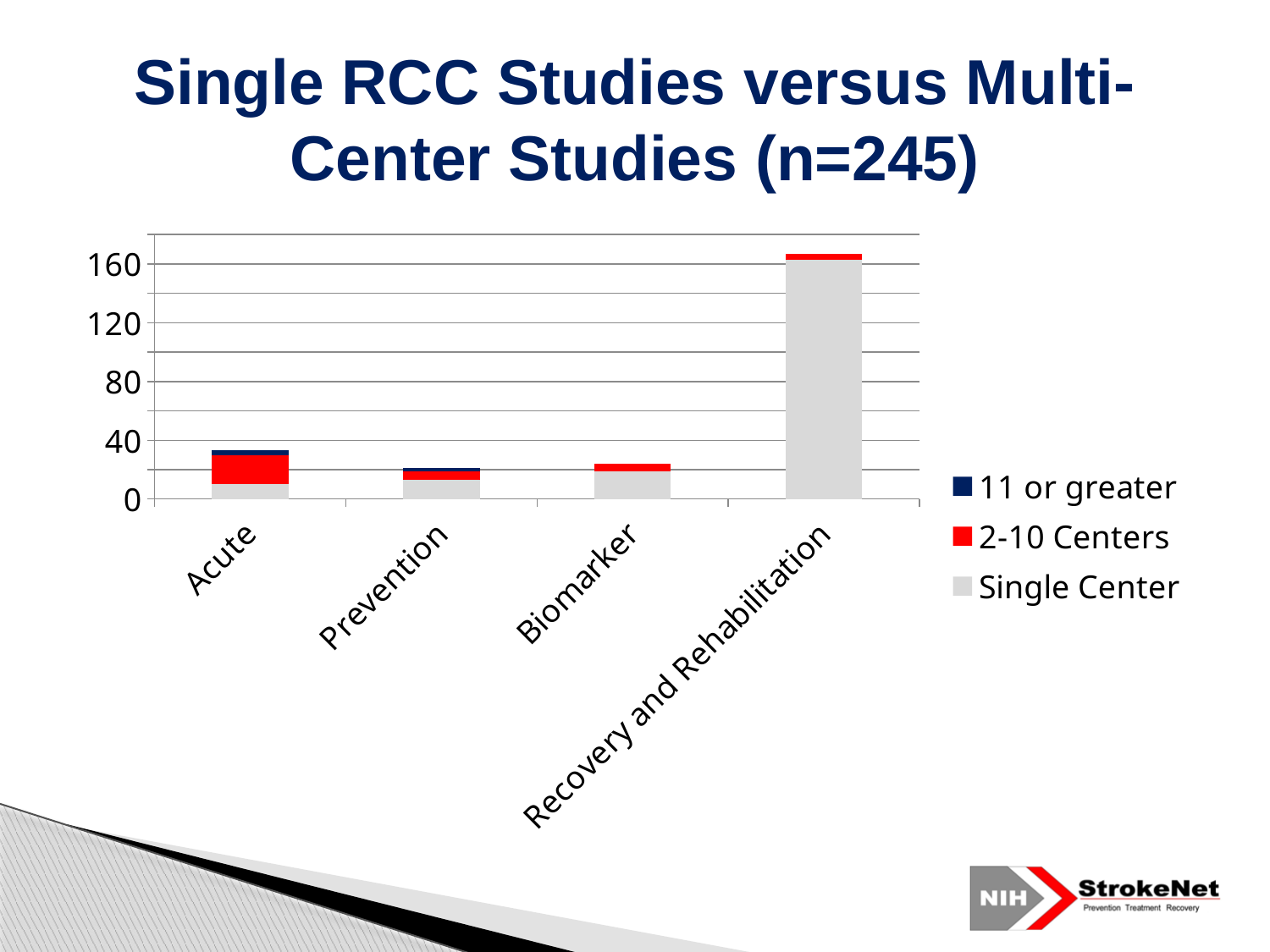
How many series does the chart's legend list? 3 Which series makes up most of the Recovery and Rehabilitation bar? Single Center How many categories are shown on the x axis of the chart? 4 Which category has the tallest stacked bar? Recovery and Rehabilitation What is the title of the slide containing the chart? Single RCC Studies versus Multi-Center Studies (n=245) Which has the taller stacked bar, Recovery and Rehabilitation or Biomarker? Recovery and Rehabilitation Is the total value for Biomarker greater or less than 40? less Is the total value for Acute greater or less than 40? less Is the total value for Recovery and Rehabilitation greater or less than 160? greater What kind of chart is shown on the slide? Stacked bar chart Which has the taller stacked bar, Acute or Prevention? Acute